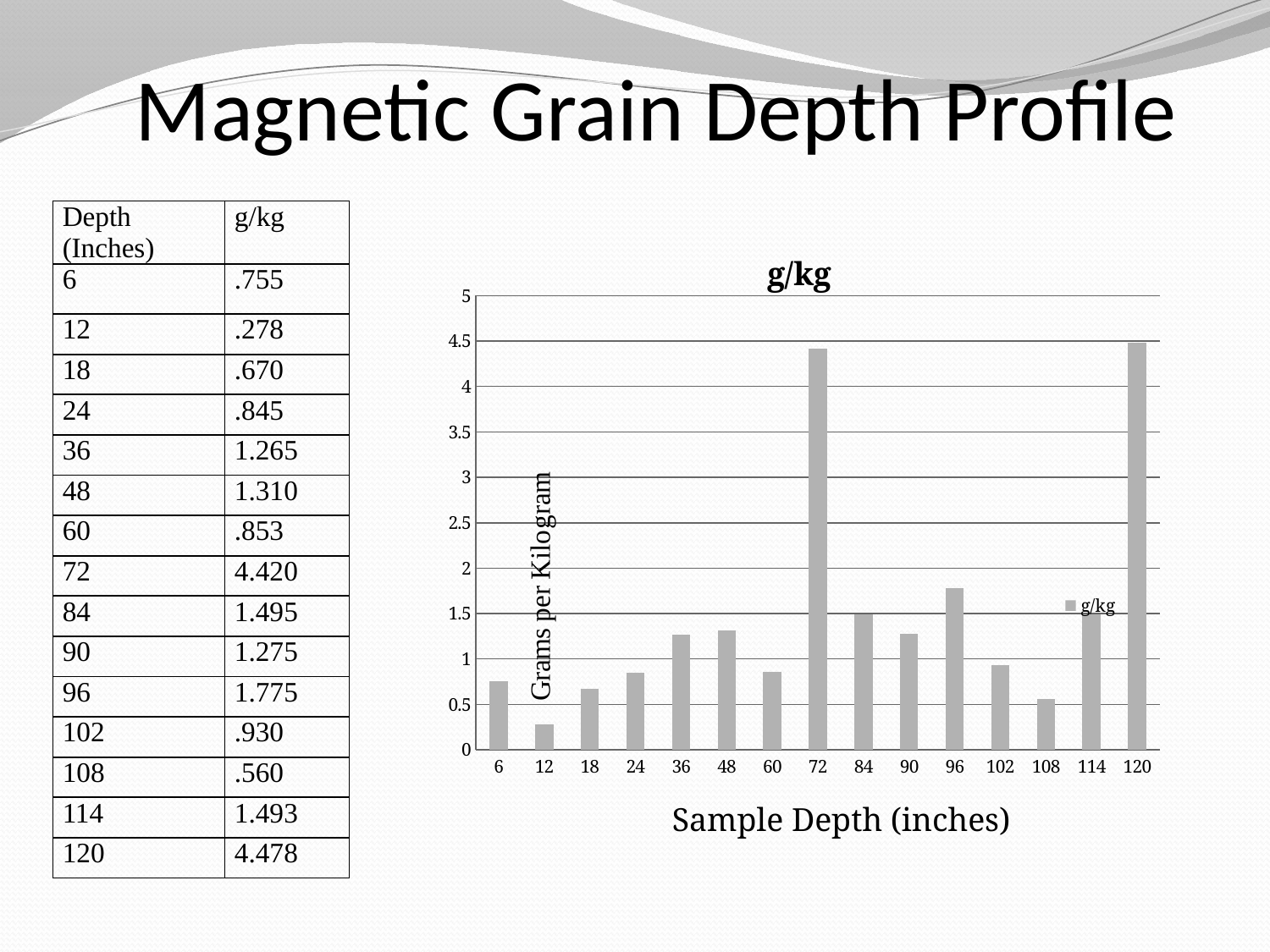
What is the difference in g/kg between the depths of 120 inches and 72 inches? 0.058 Is the g/kg value at a depth of 84 inches greater or less than 1? greater Which sample depth has the lowest g/kg value? 12 Is the g/kg value at a depth of 108 inches greater or less than 1? less What is the g/kg value at a depth of 72 inches? 4.420 What kind of chart is shown on the slide? bar chart What is the title of the chart? g/kg What is the g/kg value at a depth of 96 inches? 1.775 How many sample depths are plotted on the chart? 15 Which has a larger g/kg value, a depth of 36 inches or a depth of 60 inches? 36 How many series does the chart legend list? 1 Which sample depth has the highest g/kg value? 120